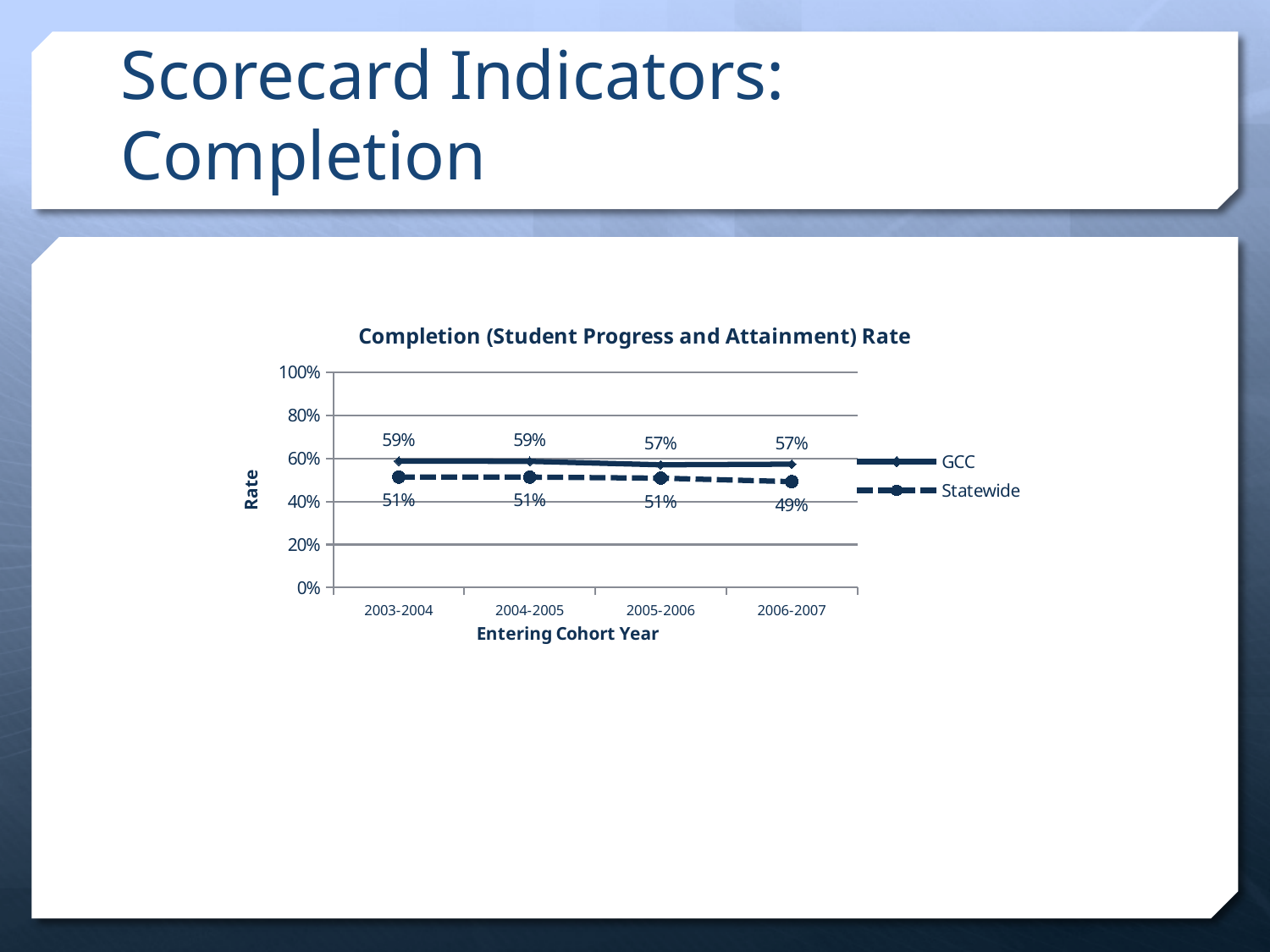
What type of chart is shown on the slide? line chart What is the title of the chart? Completion (Student Progress and Attainment) Rate Which series has the higher completion rate for the 2004-2005 cohort, GCC or Statewide? GCC Which entering cohort year has the lowest Statewide completion rate? 2006-2007 Is the Statewide completion rate for the 2006-2007 cohort greater or less than 60%? less What is the Statewide completion rate for the 2006-2007 entering cohort? 49% What is the GCC completion rate for the 2003-2004 entering cohort? 59% What is the GCC completion rate for the 2005-2006 entering cohort? 57% How many entering cohort years are shown on the x axis? 4 How many series does the legend list? 2 What is the difference between the GCC and Statewide completion rates for the 2006-2007 cohort? 8% What is the difference between the GCC and Statewide completion rates for the 2003-2004 cohort? 8%